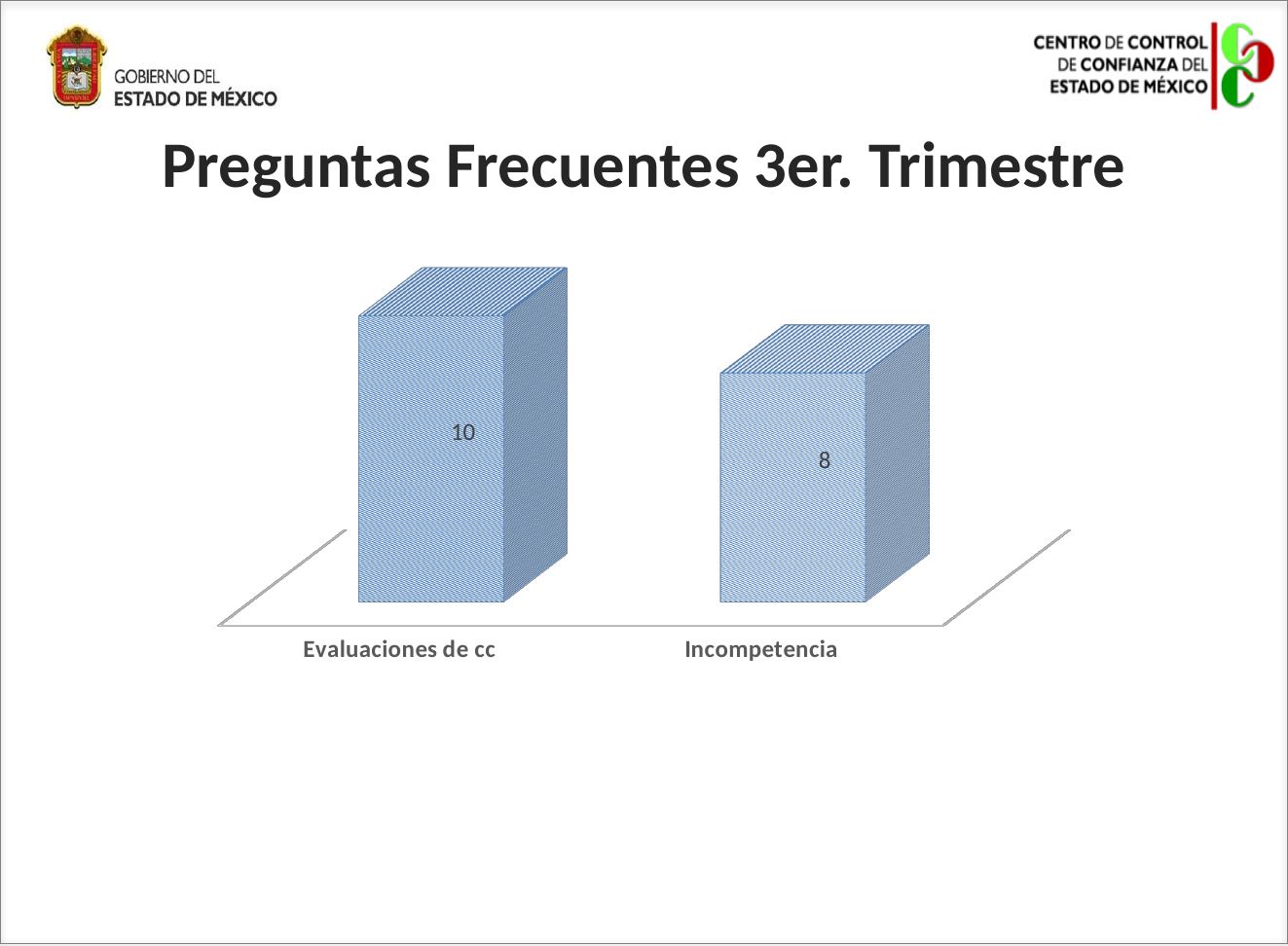
Which category has the lowest value? Incompetencia How many categories are shown in the chart? 2 Which category has the highest value? Evaluaciones de cc What is the value for Incompetencia? 8 What is the title of the slide containing the chart? Preguntas Frecuentes 3er. Trimestre What colour are the bars in the chart? Blue What is the difference between the values for Evaluaciones de cc and Incompetencia? 2 What is the value for Evaluaciones de cc? 10 What kind of chart is shown on the slide? Bar chart Do the values rise or fall from left to right across the categories? Fall What is the total of the two values shown in the chart? 18 Which is larger, the value for Evaluaciones de cc or the value for Incompetencia? Evaluaciones de cc